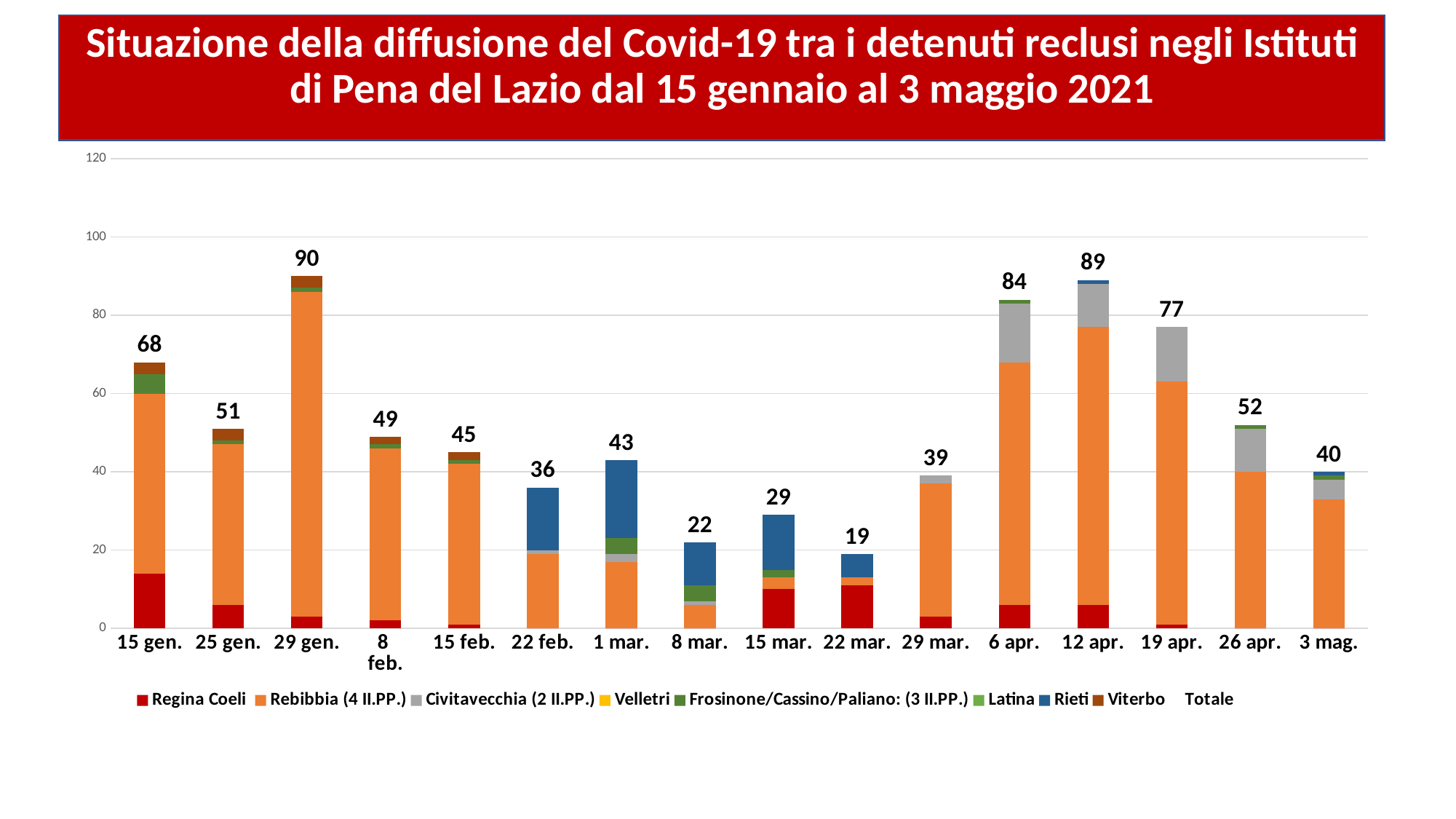
Which date has the lowest total? 22 mar. Which date has the highest total? 29 gen. What is the total value shown for 29 gen.? 90 How many entries does the legend list? 9 Do the totals rise or fall from 22 mar. to 12 apr.? rise Is the Regina Coeli segment for 15 gen. greater or less than 20? less What is the total value shown for 8 mar.? 22 Which has a larger total, 6 apr. or 12 apr.? 12 apr. What is the total value shown for 3 mag.? 40 What kind of chart is shown on the slide? Stacked bar chart How many dates are shown on the x axis? 16 What is the difference between the highest total (29 gen.) and the lowest total (22 mar.)? 71